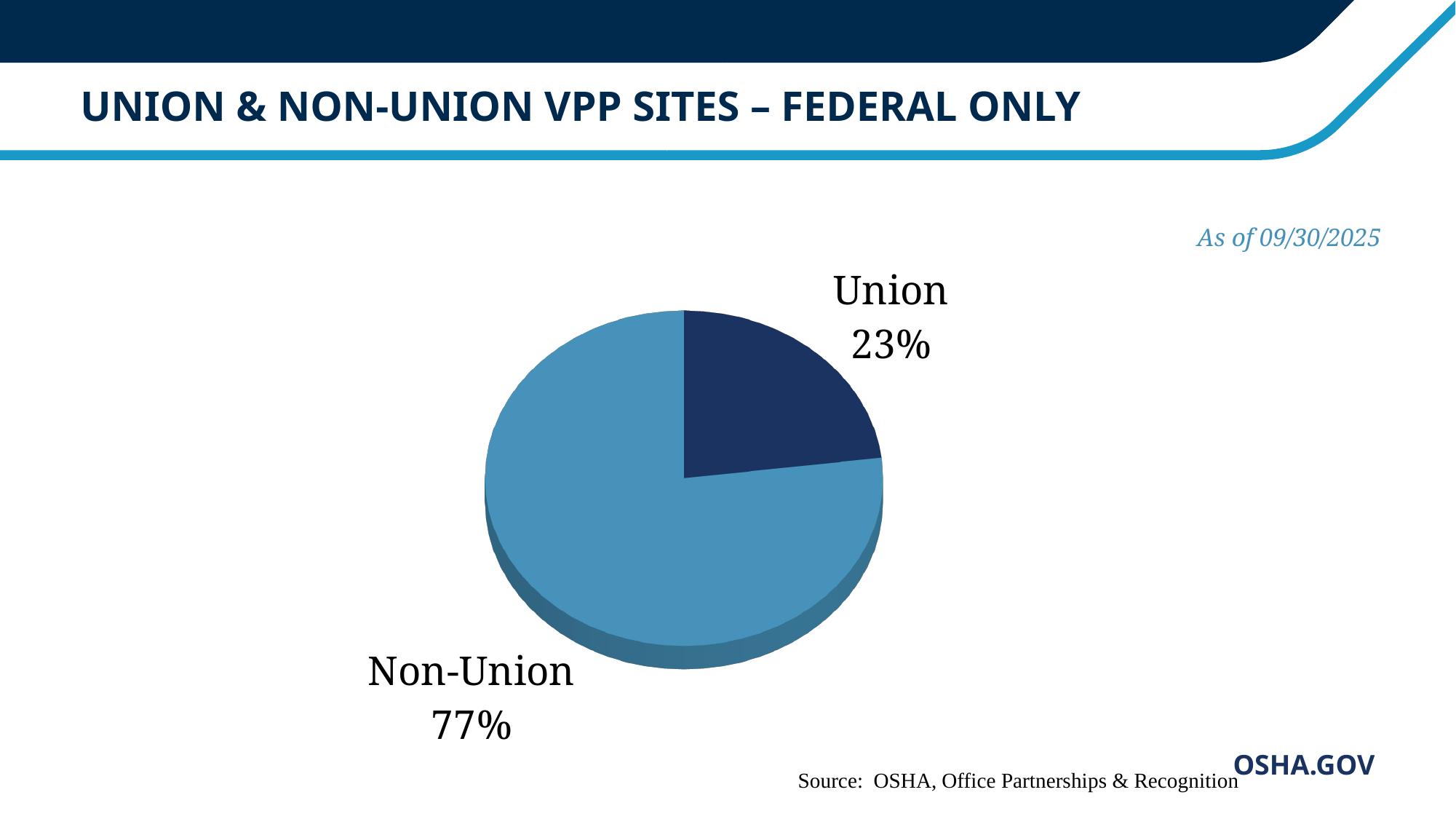
What kind of chart is shown on the slide? Pie chart Which slice is the smallest? Union How many slices does the pie chart have? 2 Which is larger, the Union share or the Non-Union share? Non-Union As of what date is the chart data reported? 09/30/2025 What is the difference in percentage points between the Non-Union and Union shares? 54 Which slice is the largest? Non-Union What share of the pie is Non-Union? 77% What is the title of the slide? UNION & NON-UNION VPP SITES – FEDERAL ONLY What share of the pie is Union? 23%